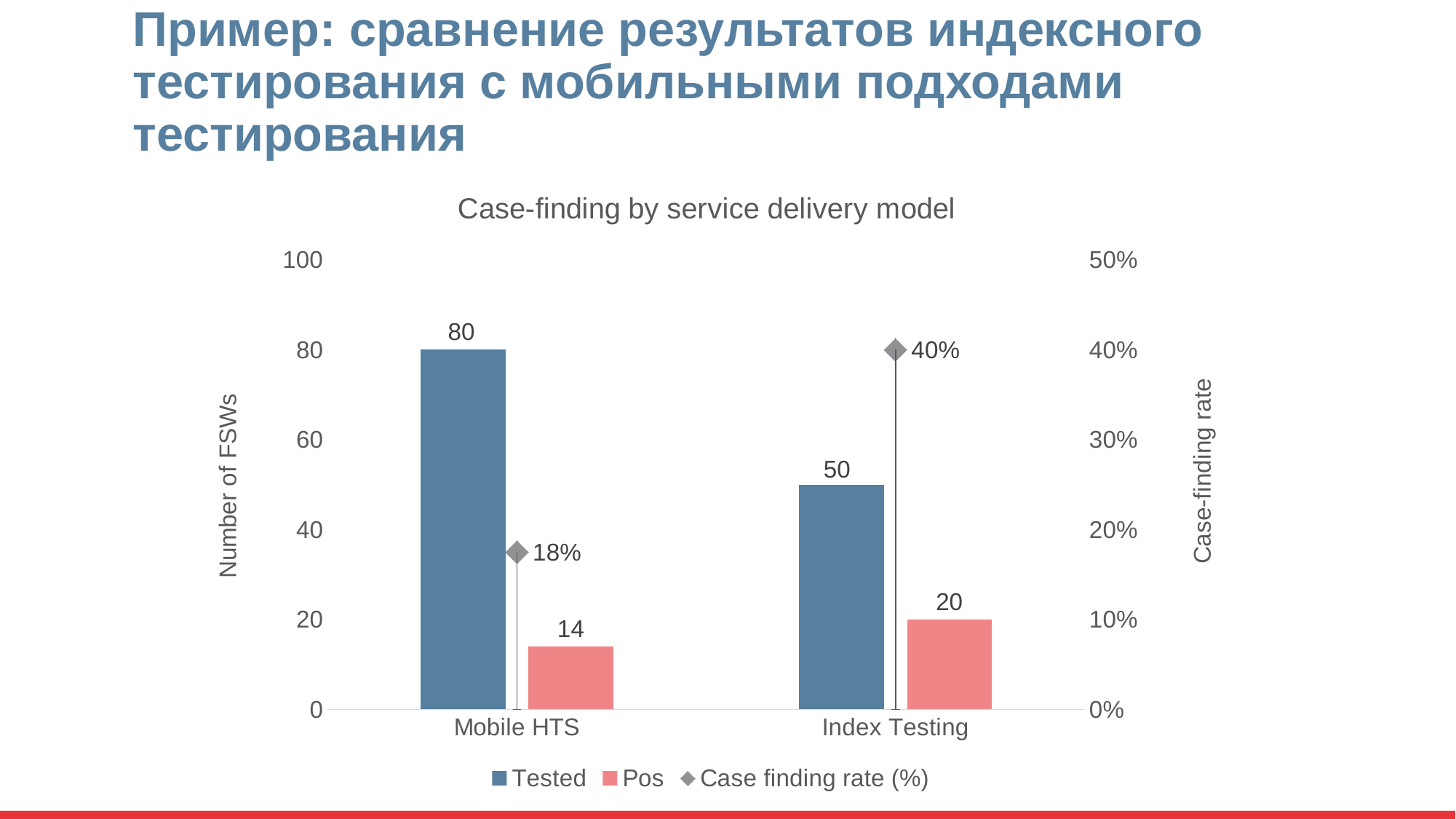
How many series does the legend list? 3 Is the case finding rate for Index Testing higher or lower than for Mobile HTS? higher How many service delivery models are shown on the x axis? 2 What is the case finding rate for Mobile HTS? 18% What is the Tested value for Mobile HTS? 80 Which service delivery model has the higher Tested value? Mobile HTS What is the Pos value for Index Testing? 20 What is the label of the right-hand vertical axis? Case-finding rate Which service delivery model has the lower Pos value? Mobile HTS What is the difference between the Tested values for Mobile HTS and Index Testing? 30 What is the title of the chart? Case-finding by service delivery model What is the case finding rate for Index Testing? 40%